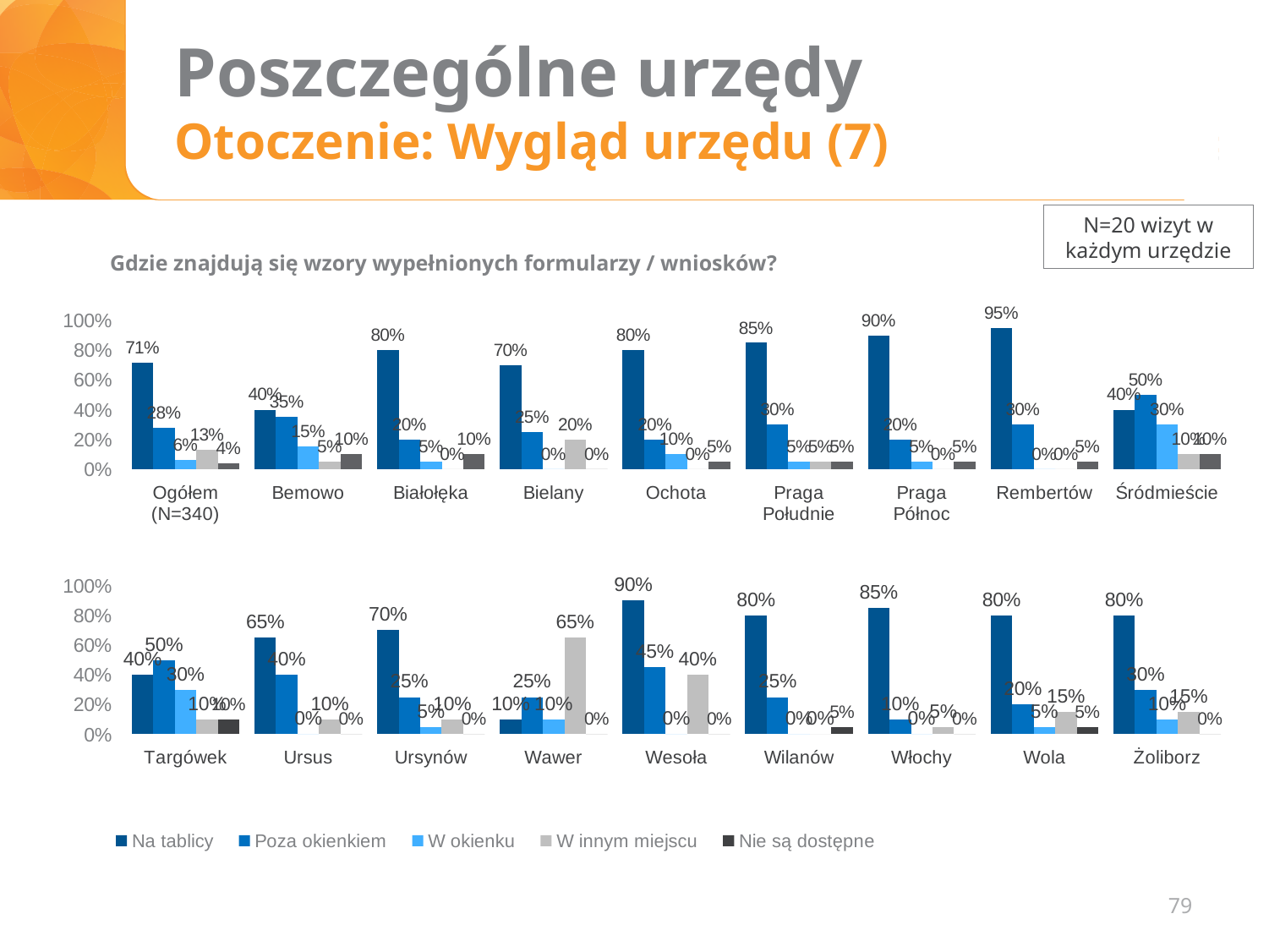
In the top chart, what is the value for 'Poza okienkiem' for Śródmieście? 50% In the top chart, what is the value for 'Na tablicy' for Rembertów? 95% In the top chart, which office has the highest value for 'Na tablicy'? Rembertów In the bottom chart, what is the value for 'W innym miejscu' for Wawer? 65% What kind of chart is shown on the slide? Bar chart How many offices (categories) are shown in the bottom chart? 9 In the top chart, what is the difference between the 'Na tablicy' value for Rembertów and for Ogółem (N=340)? 24 percentage points In the top chart, what is the value for 'Na tablicy' for Ogółem (N=340)? 71% In the top chart, which is larger: the 'Na tablicy' value for Praga Północ or for Bemowo? Praga Północ How many series does the legend list? 5 In the bottom chart, which office has the highest value for 'Na tablicy'? Wesoła In the bottom chart, which office has the lowest value for 'Na tablicy'? Wawer